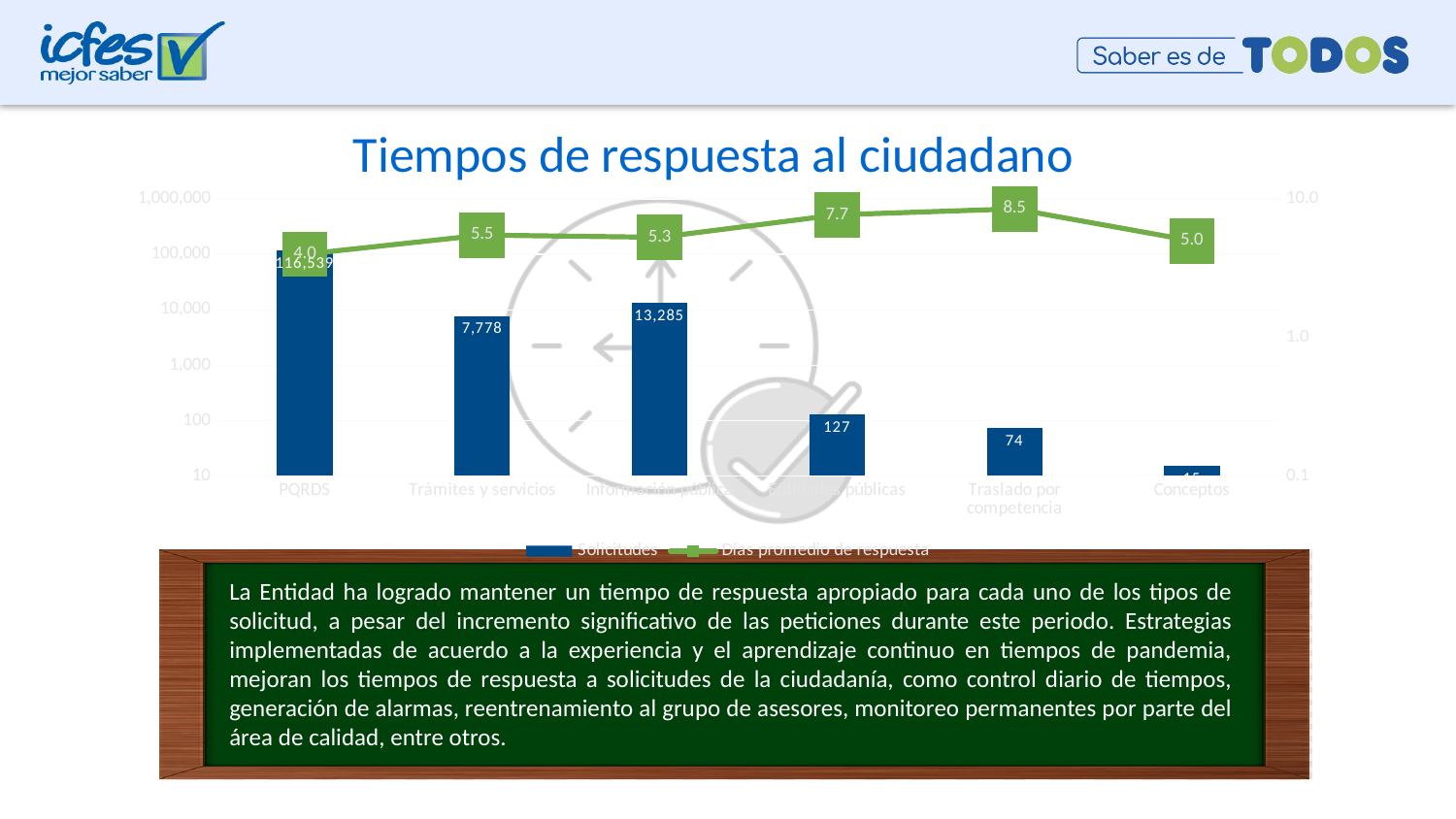
What is the number of Solicitudes for PQRDS? 116,539 How many series does the chart legend list? 2 What is the title of the chart? Tiempos de respuesta al ciudadano Which category has the lowest value of Días promedio de respuesta? PQRDS What is the difference in Días promedio de respuesta between Traslado por competencia and Conceptos? 3.5 What is the value of Días promedio de respuesta for Traslado por competencia? 8.5 Is the number of Solicitudes for Traslado por competencia greater or less than 100? less What kind of chart is shown on the slide? A combined bar and line chart What is the value of Días promedio de respuesta for Conceptos? 5.0 What is the number of Solicitudes for Trámites y servicios? 7,778 What is the number of Solicitudes for Traslado por competencia? 74 Which category has the highest number of Solicitudes? PQRDS